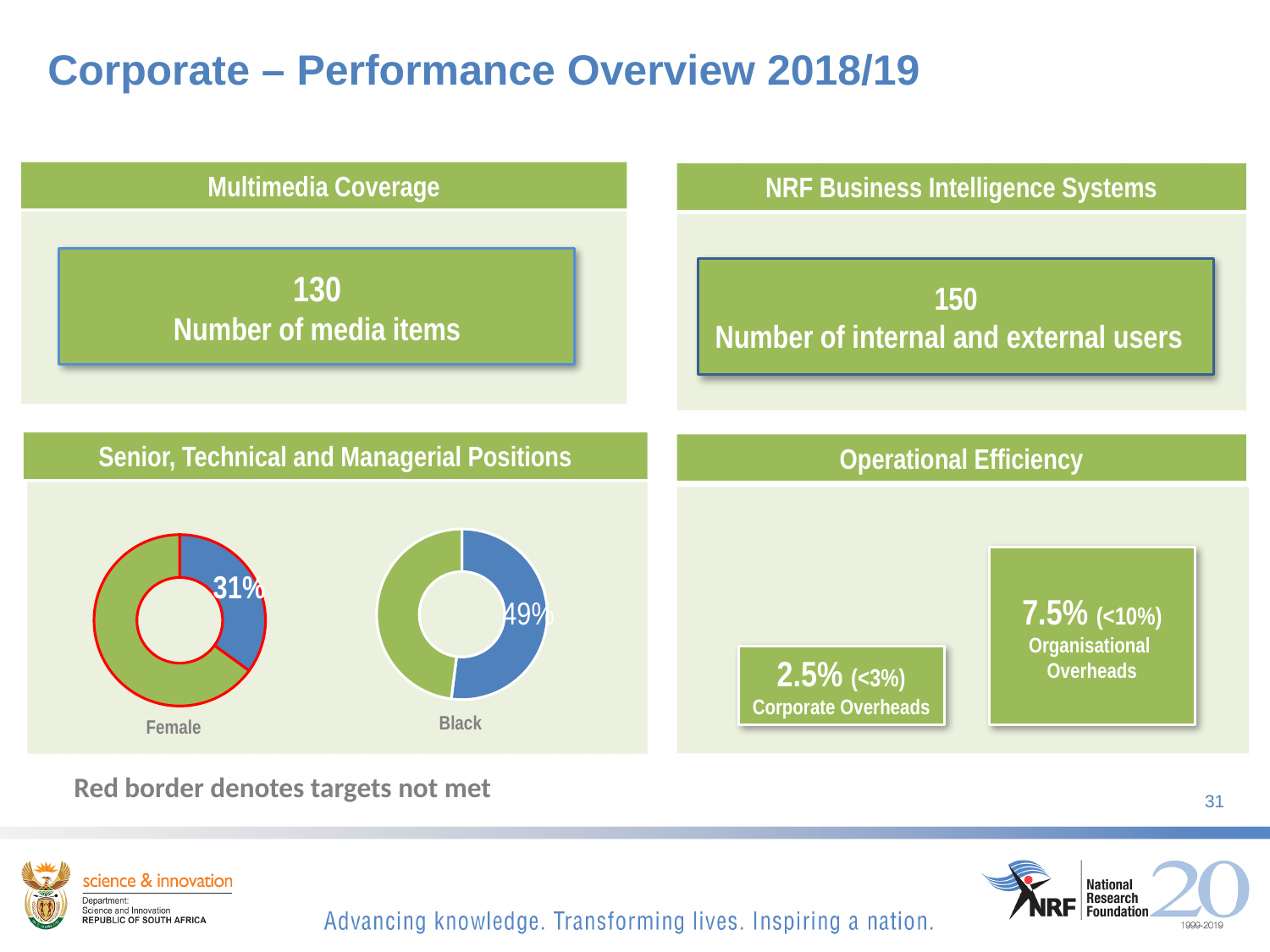
In the Senior, Technical and Managerial Positions panel, what percentage is shown on the Female donut chart? 31% How many donut charts are shown in the Senior, Technical and Managerial Positions panel? 2 In the Senior, Technical and Managerial Positions panel, what percentage is shown on the Black donut chart? 49% What kind of chart is used to show the Female and Black shares in the Senior, Technical and Managerial Positions panel? Donut (pie) chart Which is larger, the Female share or the Black share in Senior, Technical and Managerial Positions? Black According to the note on the slide, what does a red border around a chart denote? Targets not met Which of the two donut charts in the Senior, Technical and Managerial Positions panel has a red border? Female Which donut chart shows the smaller highlighted share, Female or Black? Female What is the difference in percentage points between the Black share (49%) and the Female share (31%) in Senior, Technical and Managerial Positions? 18 percentage points